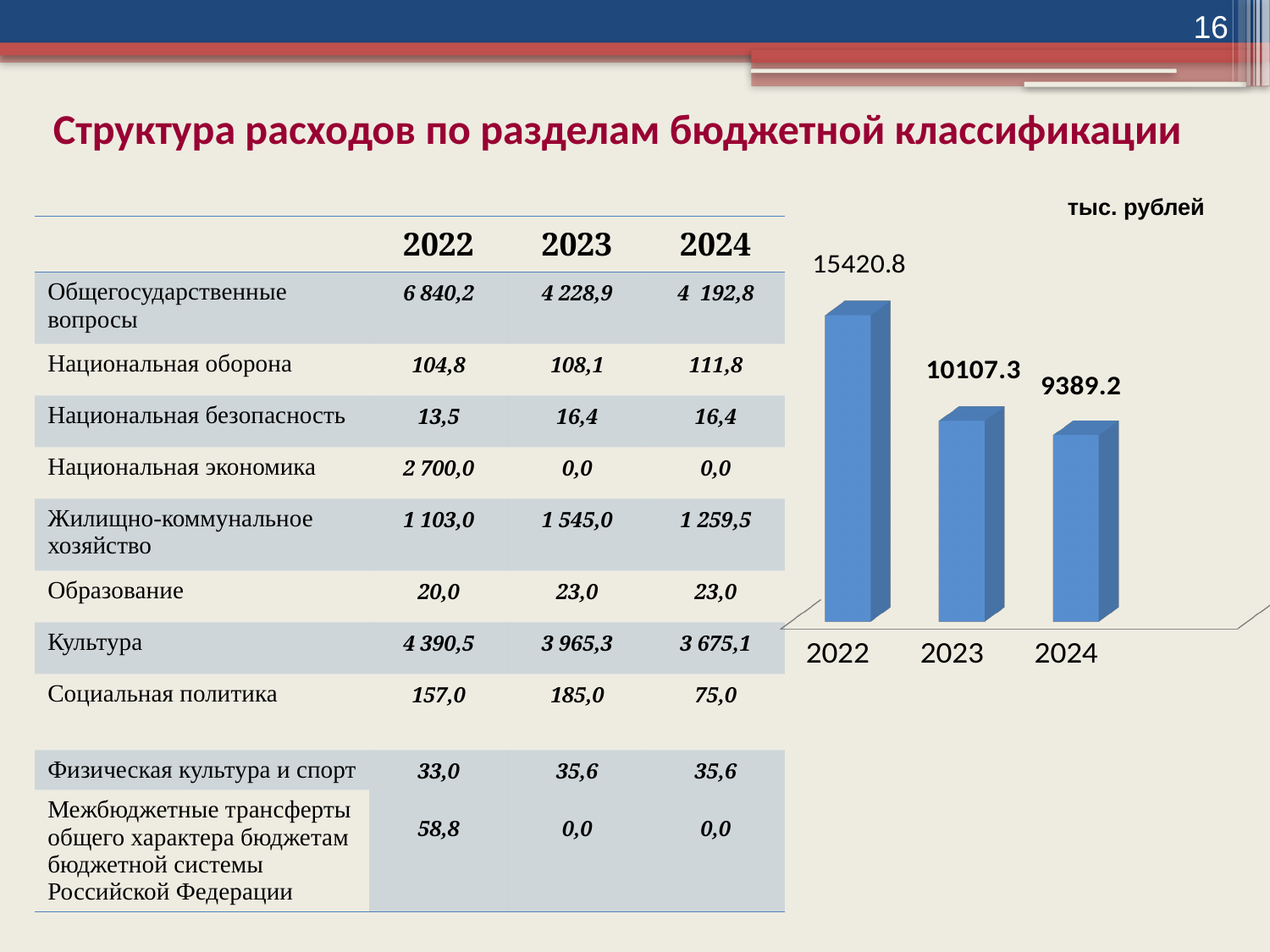
By how much does the 2022 value on the bar chart exceed the 2023 value? 5313.5 What type of chart is shown on the slide? bar chart What is the value shown for 2022 on the bar chart? 15420.8 Do the values on the bar chart rise or fall from 2022 to 2024? fall What is the value shown for 2023 on the bar chart? 10107.3 What is the difference between the 2023 and 2024 values on the bar chart? 718.1 What is the difference between the 2022 and 2024 values on the bar chart? 6031.6 Which year has the lowest bar on the chart? 2024 What is the value shown for 2024 on the bar chart? 9389.2 How many bars are shown on the chart? 3 Which year has the highest bar on the chart? 2022 On the bar chart, which is larger: the value for 2023 or the value for 2024? 2023